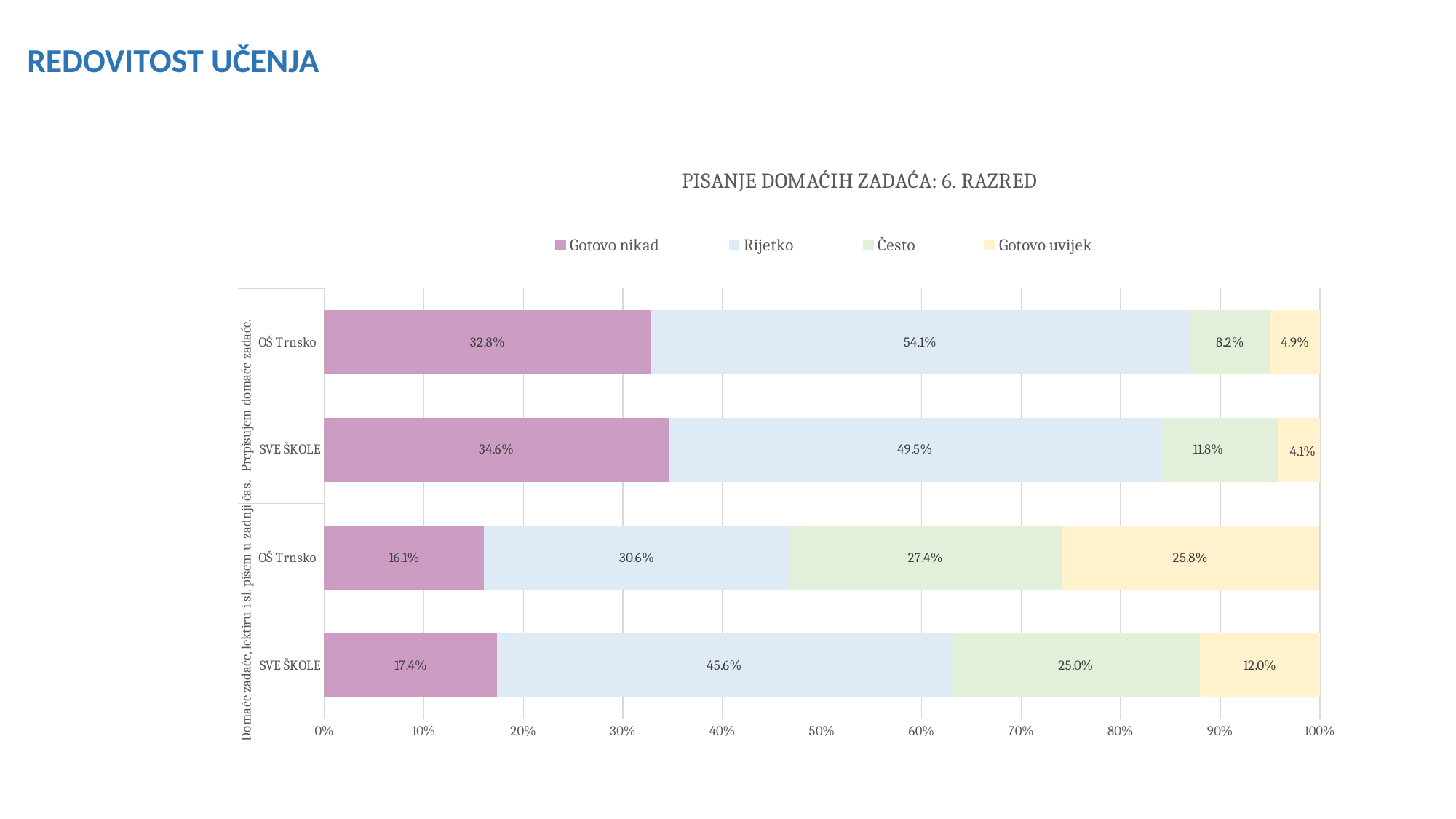
Which series has the smallest share for SVE ŠKOLE in the 'Domaće zadaće, lektiru i sl. pišem u zadnji čas.' group? Gotovo uvijek What is the 'Često' value for SVE ŠKOLE in the 'Domaće zadaće, lektiru i sl. pišem u zadnji čas.' group? 25.0% What is the title of the chart? PISANJE DOMAĆIH ZADAĆA: 6. RAZRED What is the difference between the 'Gotovo uvijek' values for OŠ Trnsko and SVE ŠKOLE in the 'Domaće zadaće, lektiru i sl. pišem u zadnji čas.' group? 13.8% How many bars are plotted in the chart? 4 How many series does the legend list? 4 What is the 'Gotovo nikad' value for SVE ŠKOLE in the 'Prepisujem domaće zadaće.' group? 34.6% What is the 'Rijetko' value for OŠ Trnsko in the 'Prepisujem domaće zadaće.' group? 54.1% What type of chart is shown on the slide? stacked bar chart Which is larger: the 'Često' value for OŠ Trnsko or for SVE ŠKOLE in the 'Prepisujem domaće zadaće.' group? SVE ŠKOLE What is the 'Gotovo uvijek' value for OŠ Trnsko in the 'Domaće zadaće, lektiru i sl. pišem u zadnji čas.' group? 25.8% Which series has the largest share for OŠ Trnsko in the 'Prepisujem domaće zadaće.' group? Rijetko